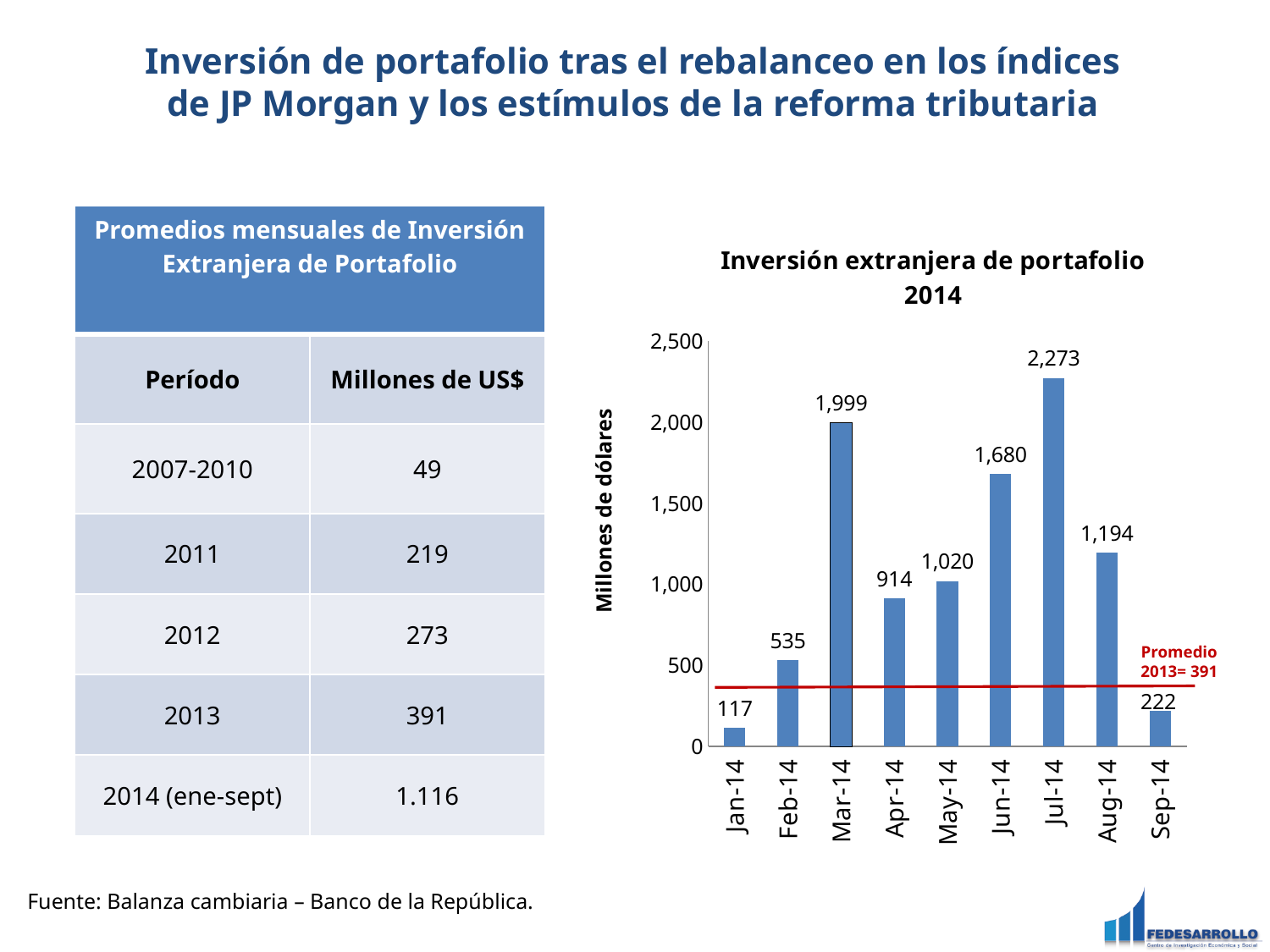
Do the values rise or fall from Jul-14 to Sep-14? fall What value does the red horizontal line in the chart represent? 391 How many months are shown on the x axis of the chart? 9 What kind of chart is shown on the slide? bar chart What is the value for Sep-14 in the chart? 222 Is the value for Aug-14 greater or less than 1,000? greater What is the value for Mar-14 in the chart? 1,999 Which month has the lowest value in the chart? Jan-14 Which month has the highest value in the chart? Jul-14 What is the difference between the values for Jul-14 and Jun-14? 593 What is the title of the chart? Inversión extranjera de portafolio 2014 Which is larger, the value for Apr-14 or the value for May-14? May-14